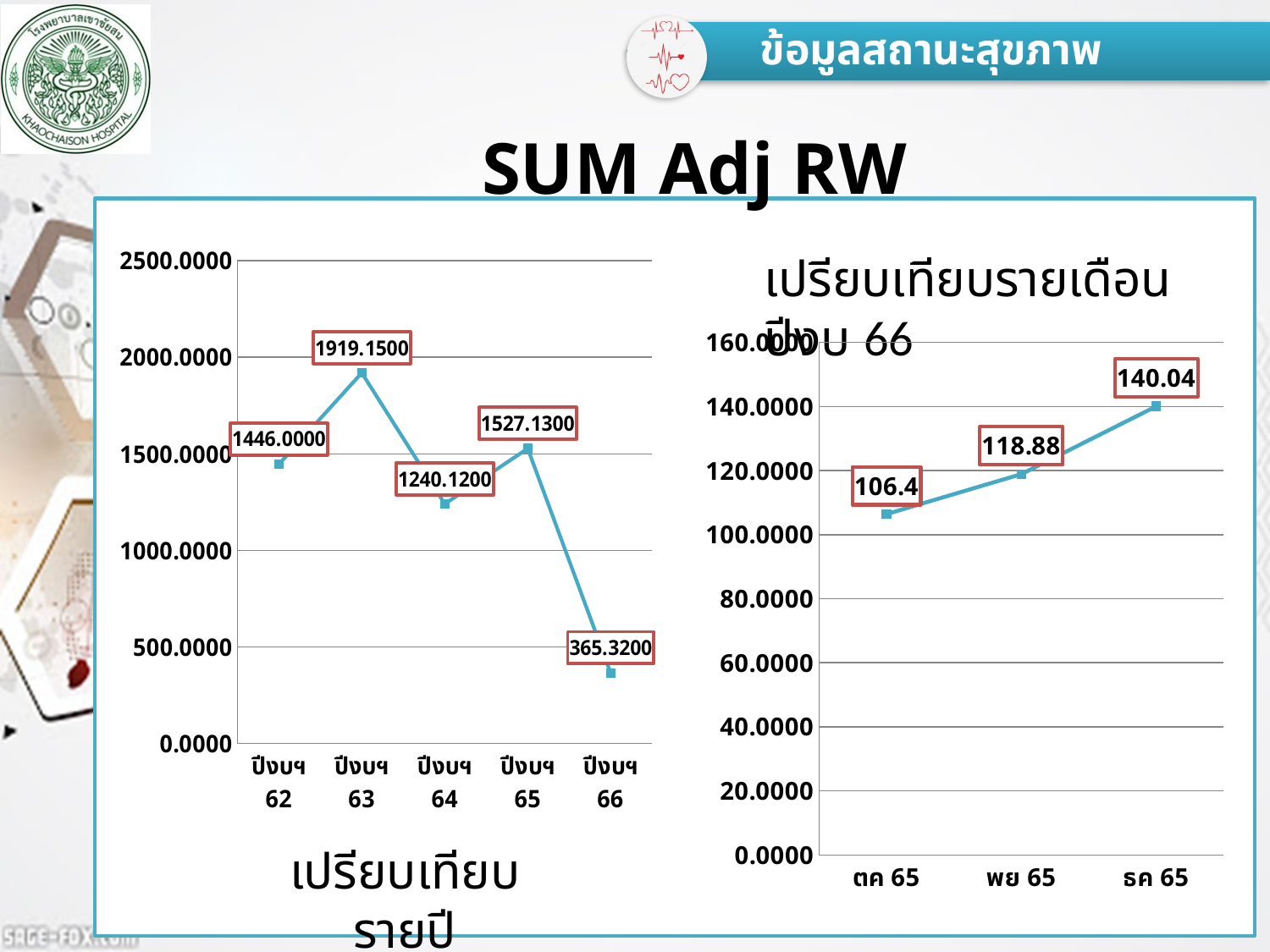
On the right chart, do the values rise or fall from ตค 65 to ธค 65? rise On the left chart, which category has the lowest value? ปีงบฯ 66 On the right chart, what is the difference between the values for ธค 65 and ตค 65? 33.64 What is the main title shown above the charts on the slide? SUM Adj RW On the right chart, what is the value for พย 65? 118.88 What kind of chart is the right chart? line chart On the left chart, what is the value for ปีงบฯ 66? 365.3200 On the left chart, which category has the highest value? ปีงบฯ 63 On the left chart, which is larger, the value for ปีงบฯ 62 or ปีงบฯ 65? ปีงบฯ 65 On the left chart, what is the difference between the values for ปีงบฯ 65 and ปีงบฯ 64? 287.0100 On the left chart, what is the value for ปีงบฯ 63? 1919.1500 How many categories are plotted on the left chart? 5